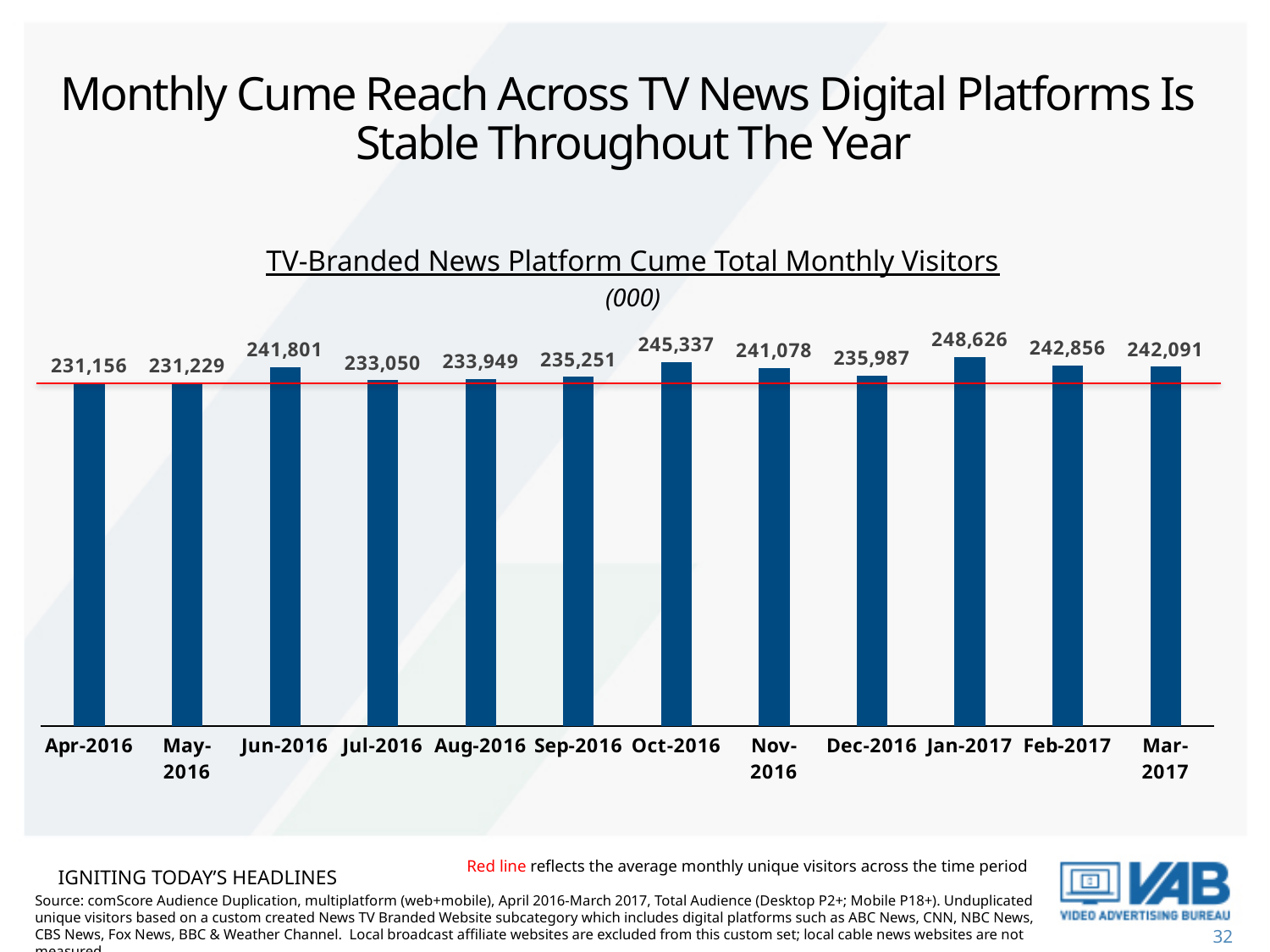
What is the value for Apr-2016? 231,156 What is the value for Dec-2016? 235,987 What kind of chart is shown on the slide? Bar chart Which is larger, the value for Jun-2016 or Jul-2016? Jun-2016 What is the value for Jan-2017? 248,626 Which month has the highest value? Jan-2017 What is the difference between the values for Oct-2016 and Sep-2016? 10,086 How many months are shown on the x axis? 12 What does the red line on the chart represent? The average monthly unique visitors across the time period What is the difference between the values for Jan-2017 and Apr-2016? 17,470 What is the value for Oct-2016? 245,337 Which month has the lowest value? Apr-2016